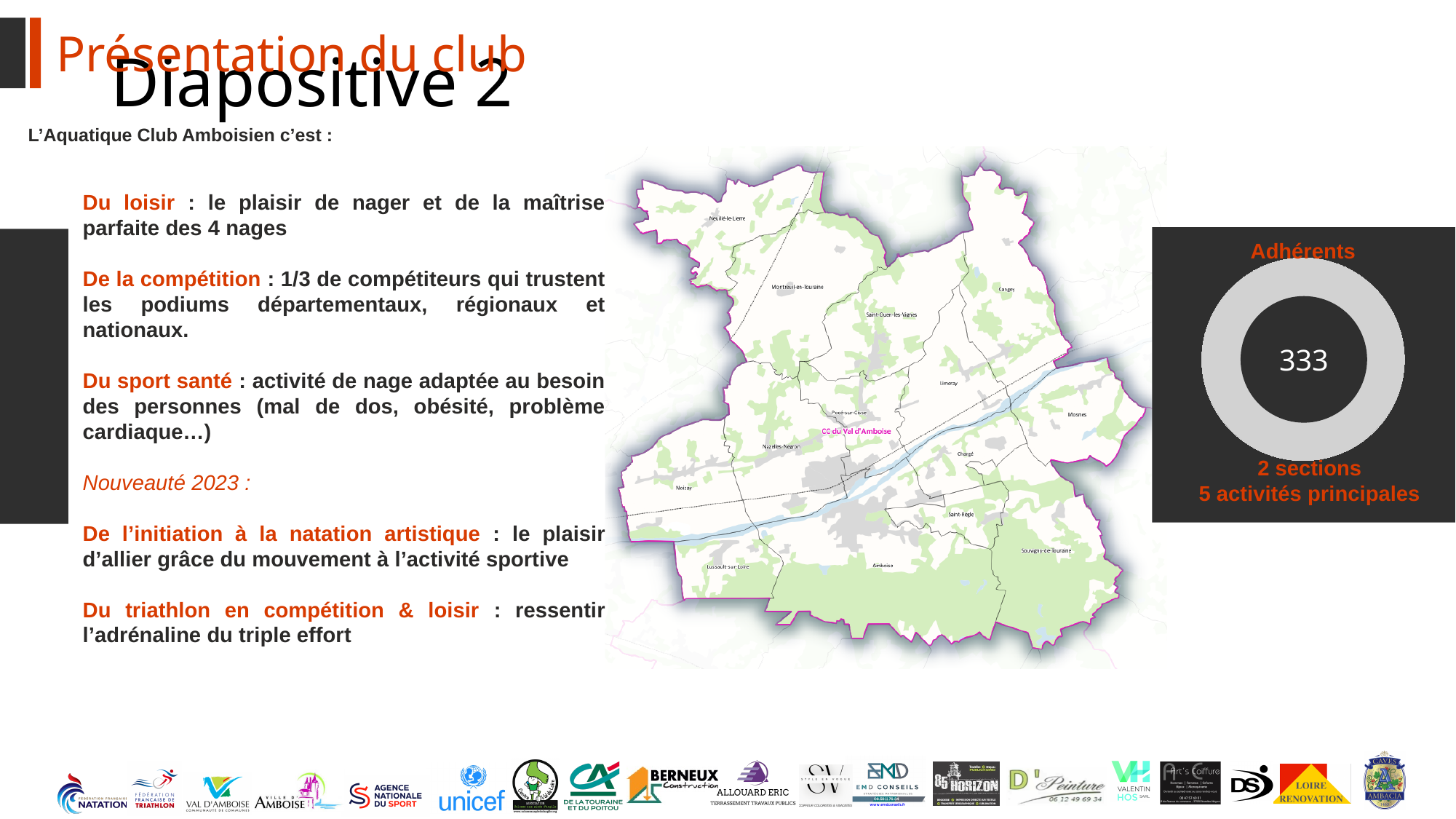
How many main activities does the text under the Adhérents doughnut chart mention? 5 activités principales Is the number shown in the centre of the Adhérents doughnut chart greater or less than 300? greater What is the title of the doughnut chart on the right of the slide? Adhérents What colour is the ring of the Adhérents doughnut chart? grey What kind of chart is shown in the dark panel on the right of the slide? doughnut chart How many sections does the text under the Adhérents doughnut chart mention? 2 sections What number is printed in the centre of the Adhérents doughnut chart? 333